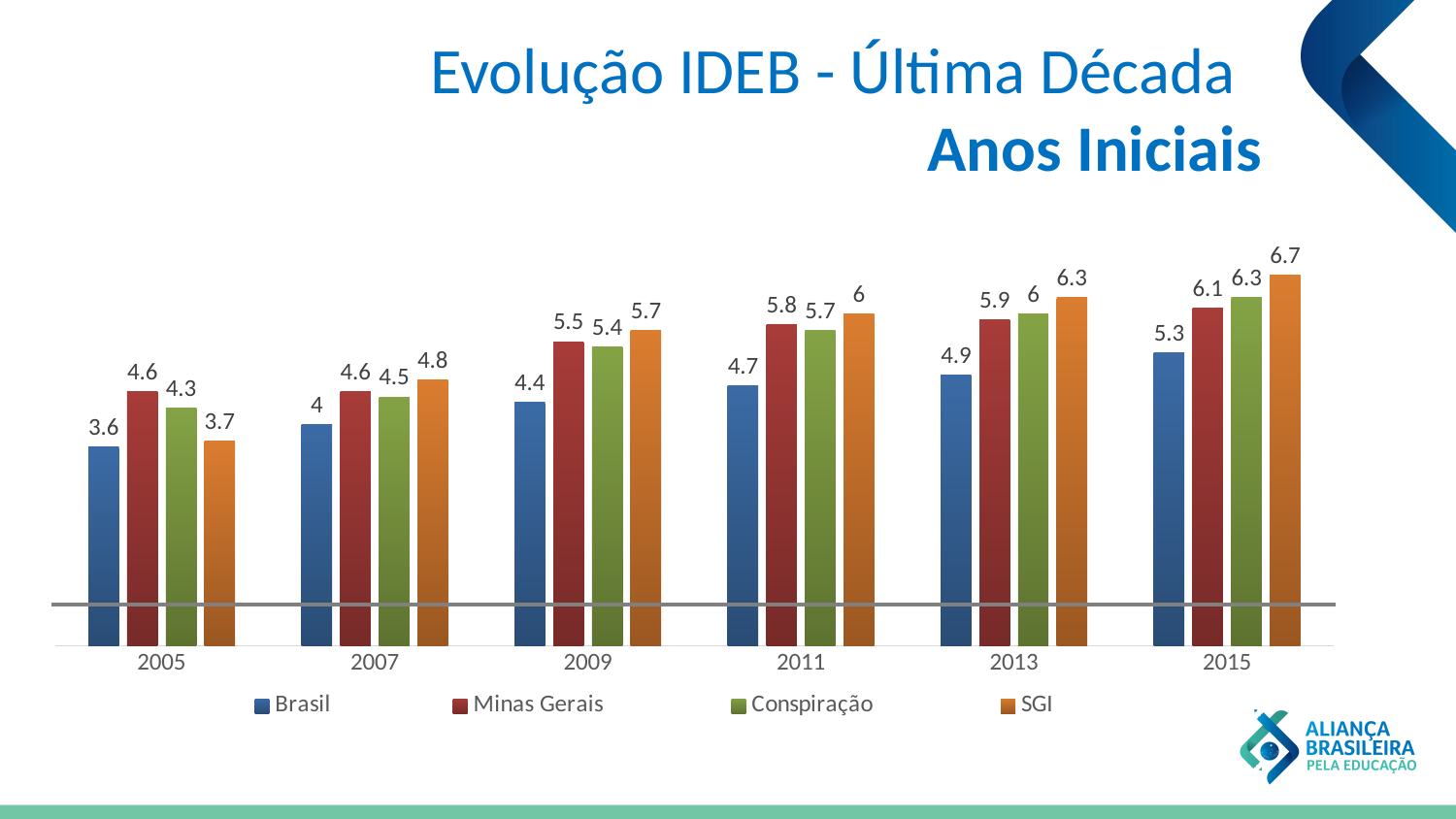
What kind of chart is shown on the slide? Bar chart What is the difference between the SGI value and the Brasil value in 2015? 1.4 How many series does the legend list? 4 Which is larger in 2005: the value for Minas Gerais or the value for SGI? Minas Gerais What is the value for Brasil in 2005? 3.6 What is the value for SGI in 2015? 6.7 What is the value for Minas Gerais in 2009? 5.5 How many years are shown on the x axis? 6 Which series has the lowest value in 2005? Brasil Do the values for Brasil rise or fall from 2005 to 2015? Rise What is the value for Conspiração in 2013? 6 In which year does SGI reach its highest value? 2015